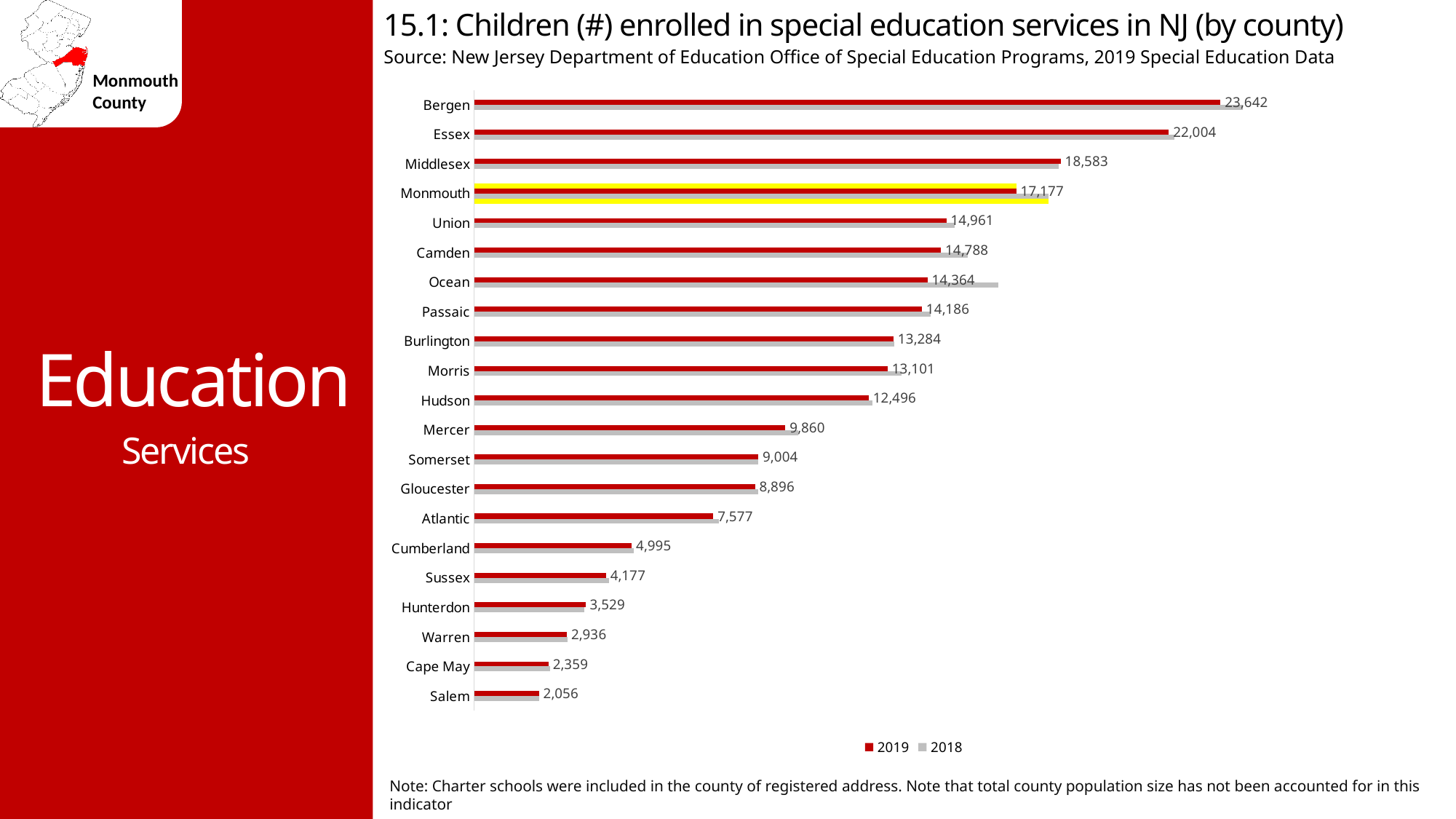
How many series does the legend list? 2 What kind of chart is shown on the slide? Bar chart Which county has the lowest 2019 value? Salem What is the 2019 value for Monmouth? 17,177 How many counties are shown on the chart? 21 What is the difference between the 2019 values for Monmouth and Union? 2,216 Which county has the highest 2019 value? Bergen What is the 2019 value for Hudson? 12,496 What is the difference between the 2019 values for Bergen and Essex? 1,638 Which county has the larger 2019 value, Mercer or Atlantic? Mercer For Ocean, which year's bar is longer, 2019 or 2018? 2018 What is the 2019 value for Cape May? 2,359